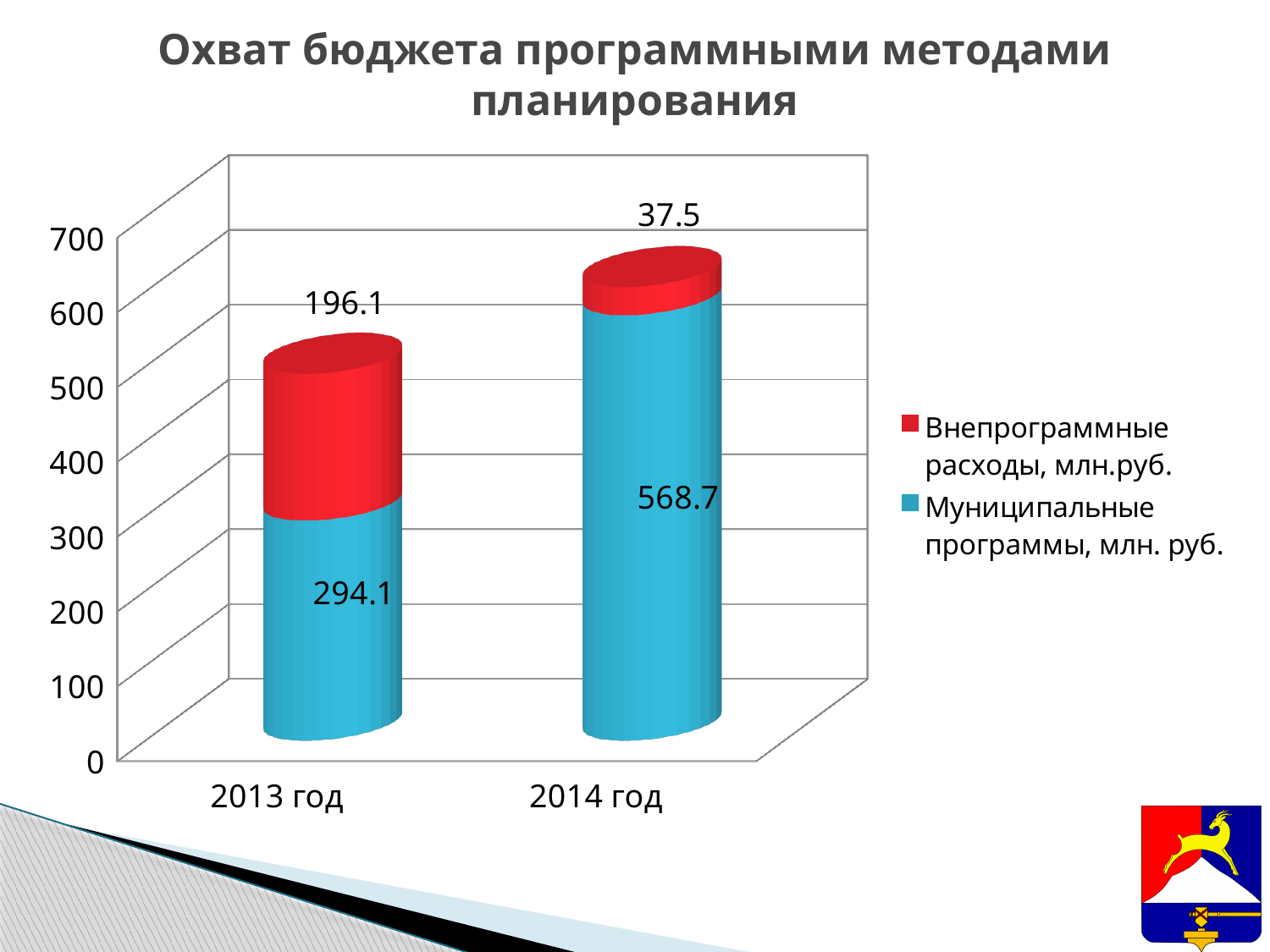
How many series does the legend list? 2 What is the difference between Внепрограммные расходы, млн.руб. in 2013 год and 2014 год? 158.6 What type of chart is shown on the slide? Stacked bar chart What is the value of Муниципальные программы, млн. руб. for 2014 год? 568.7 What is the value of Внепрограммные расходы, млн.руб. for 2014 год? 37.5 What is the total of the stacked bar for 2014 год? 606.2 What is the value of Внепрограммные расходы, млн.руб. for 2013 год? 196.1 Which year has the higher value for Муниципальные программы, млн. руб.? 2014 год What is the value of Муниципальные программы, млн. руб. for 2013 год? 294.1 What is the total of the stacked bar for 2013 год? 490.2 Which year has the lower value for Внепрограммные расходы, млн.руб.? 2014 год By how much did Муниципальные программы, млн. руб. increase from 2013 год to 2014 год? 274.6